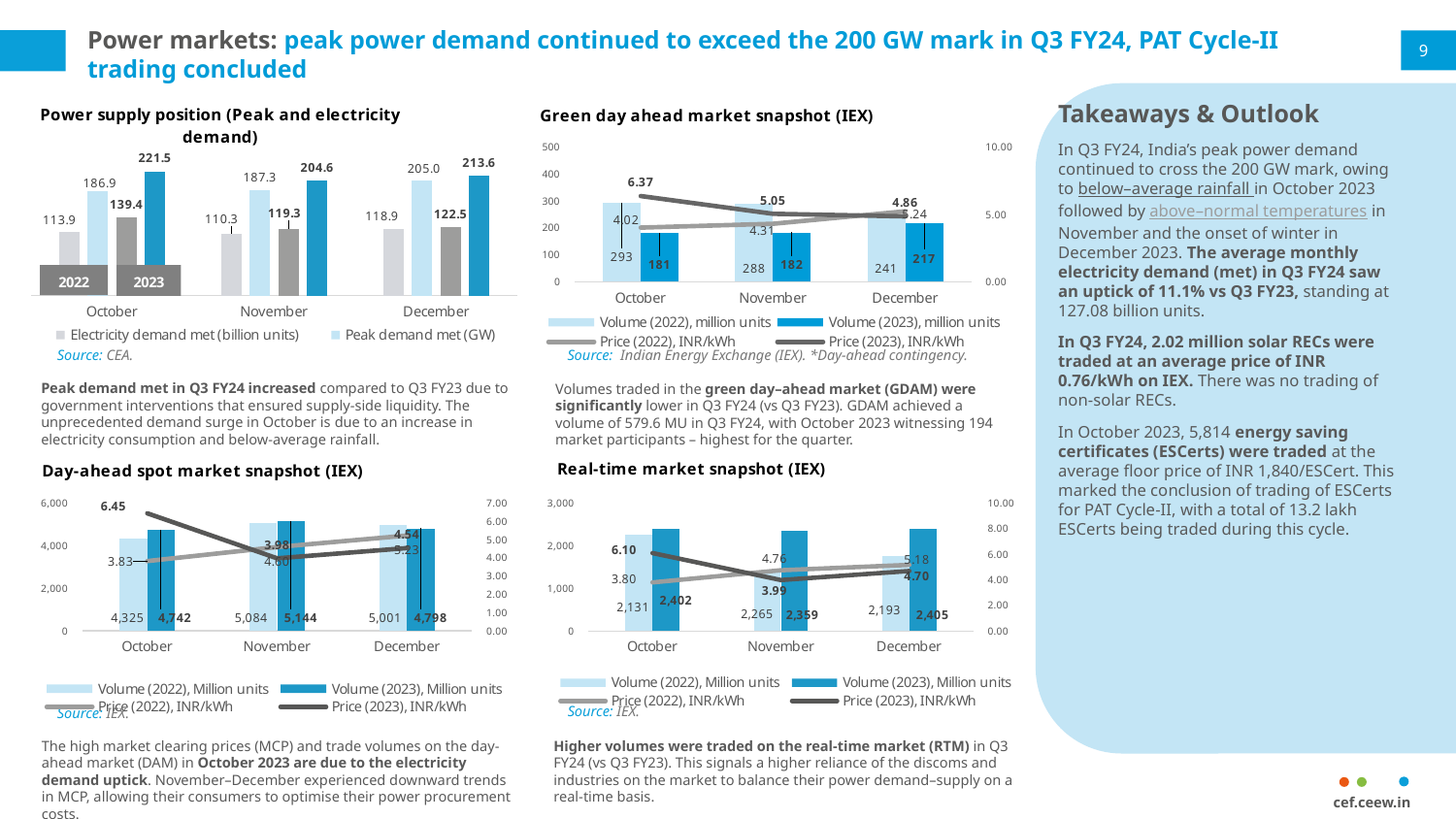
In the 'Power supply position' chart, what is the peak demand met (GW) for October 2023? 221.5 In the 'Real-time market snapshot (IEX)' chart, what is the Price (2022) for November? 4.76 In the 'Day-ahead spot market snapshot (IEX)' chart, what is the Volume (2023) for November? 5,144 In the 'Real-time market snapshot (IEX)' chart, what is the difference between Volume (2023) and Volume (2022) for October? 271 In the 'Power supply position' chart, which month has the highest peak demand met (GW) in 2023? October In the 'Power supply position' chart, what is the electricity demand met (billion units) for November 2022? 110.3 In the 'Green day ahead market snapshot (IEX)' chart, what is the Price (2023) for October? 6.37 In the 'Day-ahead spot market snapshot (IEX)' chart, which is larger, the Volume (2022) for December or the Volume (2023) for December? Volume (2022) In the 'Green day ahead market snapshot (IEX)' chart, which month has the lowest Volume (2022)? December In the 'Green day ahead market snapshot (IEX)' chart, what is the Volume (2023) for December? 217 In the 'Power supply position' chart, what is the difference between peak demand met (GW) in December 2023 and December 2022? 8.6 In the 'Real-time market snapshot (IEX)' chart, how many series does the legend list? 4